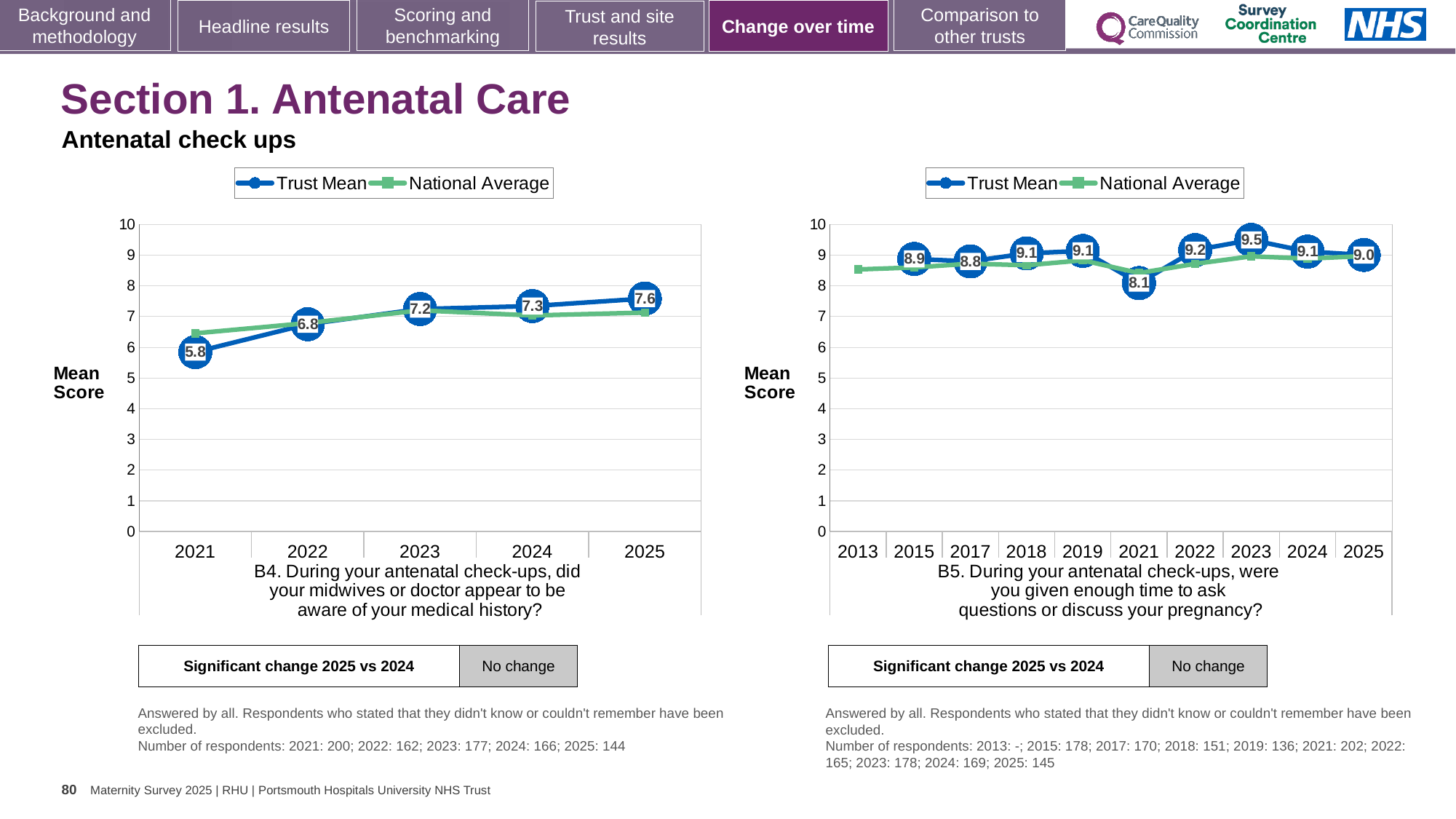
In the right chart (B5), what is the Trust Mean for 2021? 8.1 In the right chart (B5), what is the Trust Mean for 2023? 9.5 In the right chart (B5), which year has the highest Trust Mean? 2023 In the right chart (B5), is the Trust Mean for 2022 greater or less than the Trust Mean for 2021? greater In the right chart (B5), how many series does the legend list? 2 What kind of chart is the left chart (B4)? line chart In the left chart (B4), does the Trust Mean rise or fall from 2021 to 2025? rise In the left chart (B4), what is the difference between the Trust Mean in 2025 and in 2021? 1.8 In the left chart (B4), how many years are shown on the x axis? 5 In the left chart (B4), what is the Trust Mean for 2021? 5.8 In the left chart (B4), what is the Trust Mean for 2025? 7.6 In the left chart (B4), which year has the lowest Trust Mean? 2021